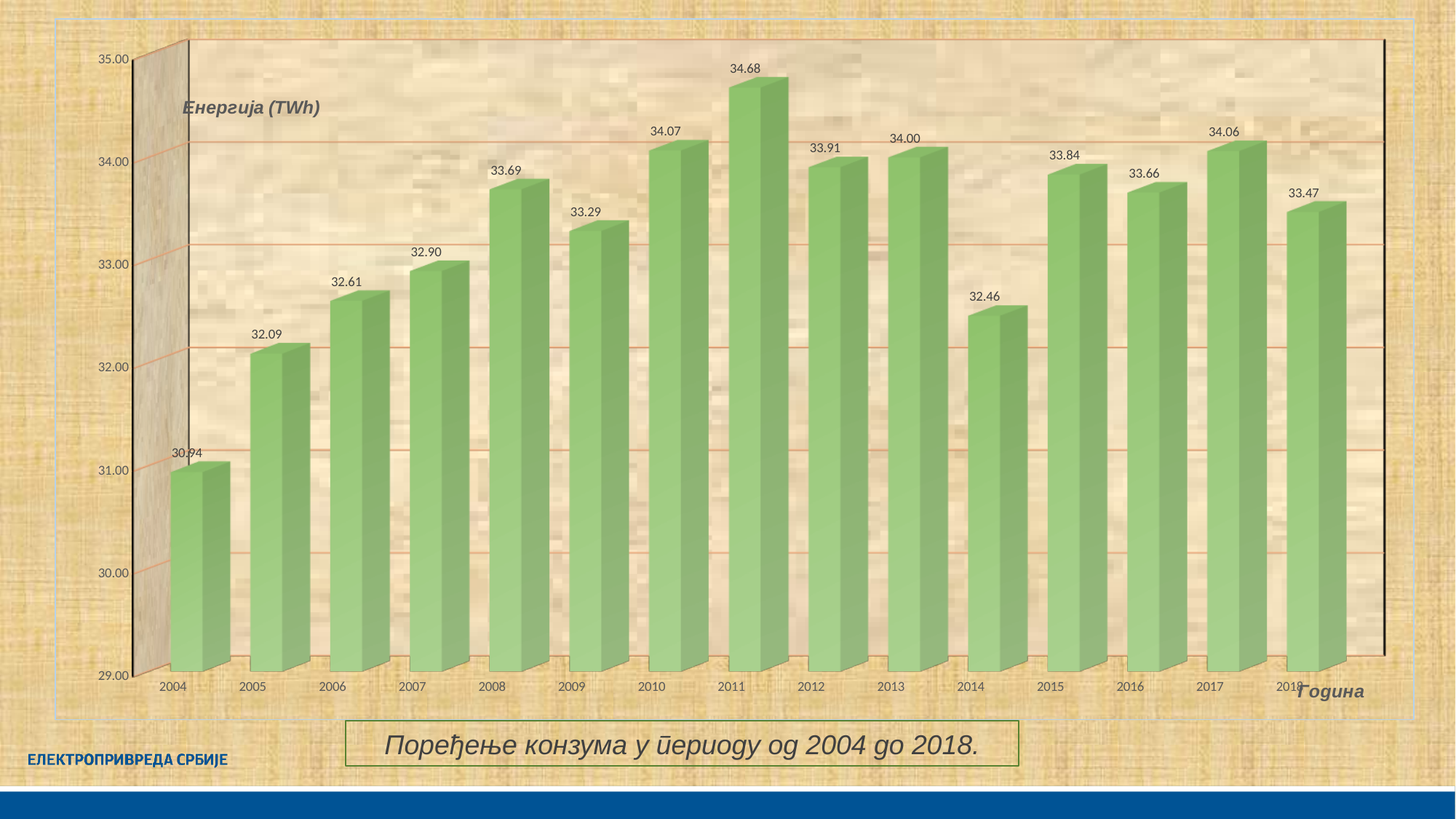
Do the values rise or fall from 2004 to 2008? rise Is the value for 2008 greater or less than 33.00? greater What is the value for 2004? 30.94 What kind of chart is shown on the slide? bar chart Which is larger, the value for 2010 or the value for 2017? 2010 Which year has the lowest value? 2004 What is the label of the vertical axis? Енергија (TWh) What is the value for 2011? 34.68 What is the difference between the values for 2011 and 2004? 3.74 How many years are shown on the x axis? 15 What is the value for 2014? 32.46 Which year has the highest value? 2011